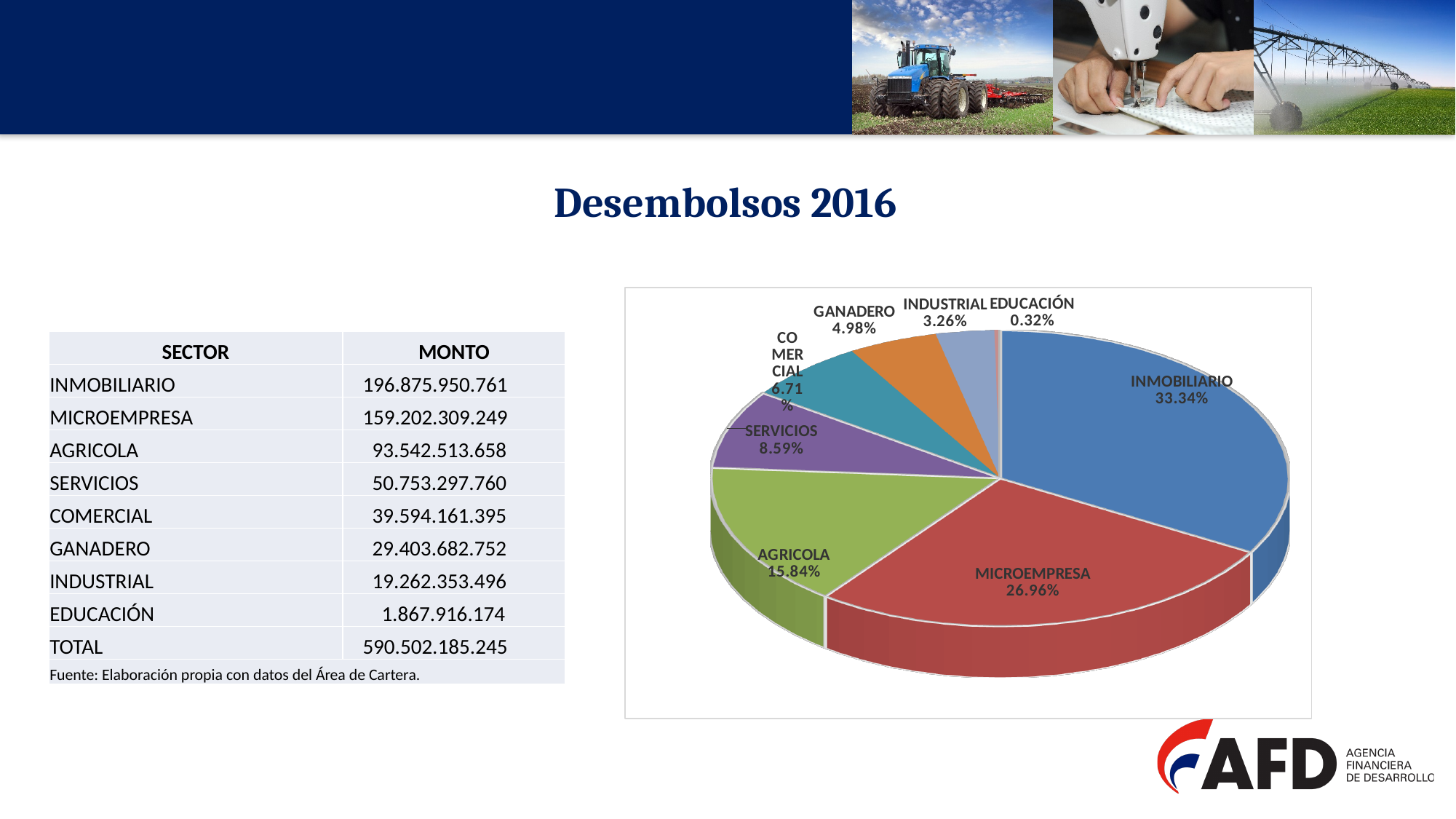
Which sector has the largest slice in the pie chart? INMOBILIARIO What is the difference in percentage points between INMOBILIARIO and MICROEMPRESA in the pie chart? 6.38 percentage points What percentage is shown for SERVICIOS in the pie chart? 8.59% What percentage is shown for GANADERO in the pie chart? 4.98% Which has a larger share in the pie chart, SERVICIOS or COMERCIAL? SERVICIOS What share of the pie chart does INMOBILIARIO represent? 33.34% What percentage is shown for MICROEMPRESA in the pie chart? 26.96% Which sector has the smallest slice in the pie chart? EDUCACIÓN What percentage is shown for EDUCACIÓN in the pie chart? 0.32% What percentage is shown for AGRICOLA in the pie chart? 15.84% What kind of chart is shown on the slide? Pie chart How many sectors (slices) are shown in the pie chart? 8